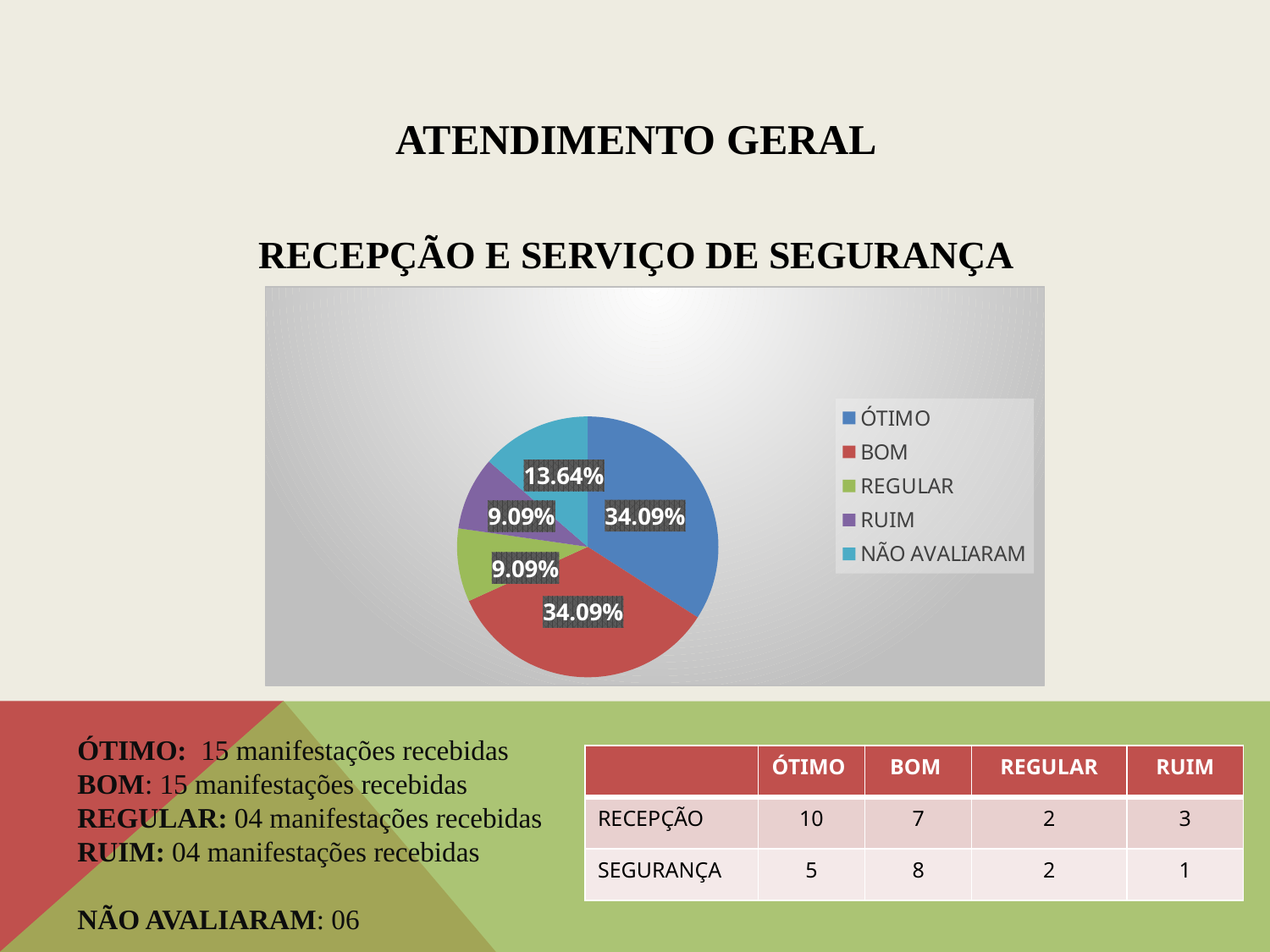
What colour is the BOM slice in the pie chart? red What percentage of the pie chart is labelled for RUIM? 9.09% What percentage of the pie chart is labelled for REGULAR? 9.09% What kind of chart is shown on the slide? pie chart How many entries does the legend of the pie chart list? 5 What percentage of the pie chart is labelled for NÃO AVALIARAM? 13.64% What percentage of the pie chart is labelled for BOM? 34.09% Which slice is larger in the pie chart, NÃO AVALIARAM or RUIM? NÃO AVALIARAM What is the difference in percentage points between the NÃO AVALIARAM slice and the REGULAR slice? 4.55% What percentage of the pie chart is labelled for ÓTIMO? 34.09% How many slices does the pie chart have? 5 What is the difference in percentage points between the ÓTIMO slice and the NÃO AVALIARAM slice? 20.45%